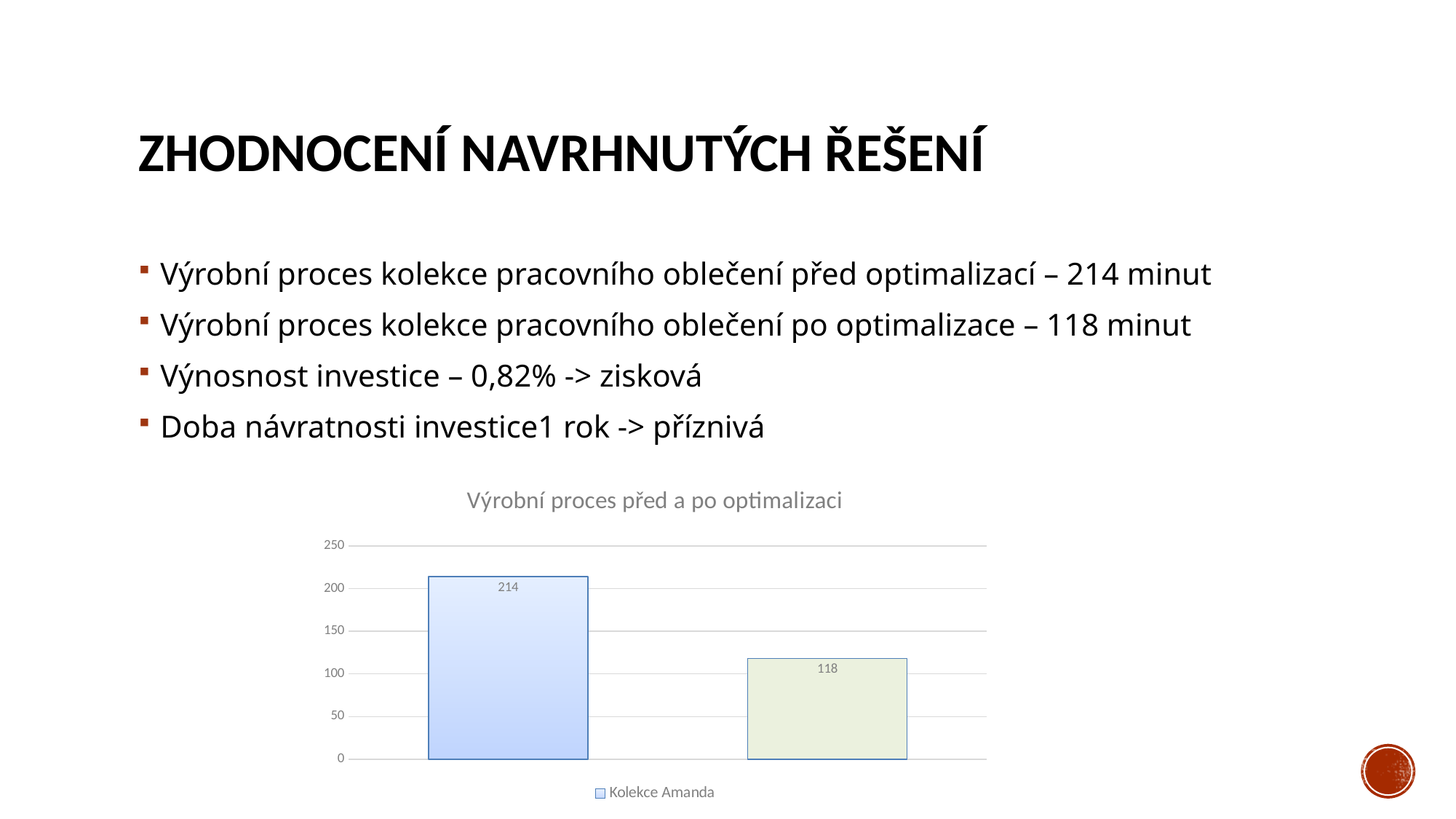
What is the value shown on the left (blue) bar in the chart? 214 Is the value of the left bar greater or less than 200? greater What is the title of the chart? Výrobní proces před a po optimalizaci How many series does the chart legend list? 1 Do the bar values rise or fall from left to right? fall What series name is shown in the chart legend? Kolekce Amanda Is the value of the right bar greater or less than 150? less Which bar is taller, the left bar or the right bar? the left bar What type of chart is shown on the slide? bar chart What is the difference between the values of the left bar and the right bar? 96 How many bars are plotted in the chart? 2 What is the value shown on the right (green) bar in the chart? 118